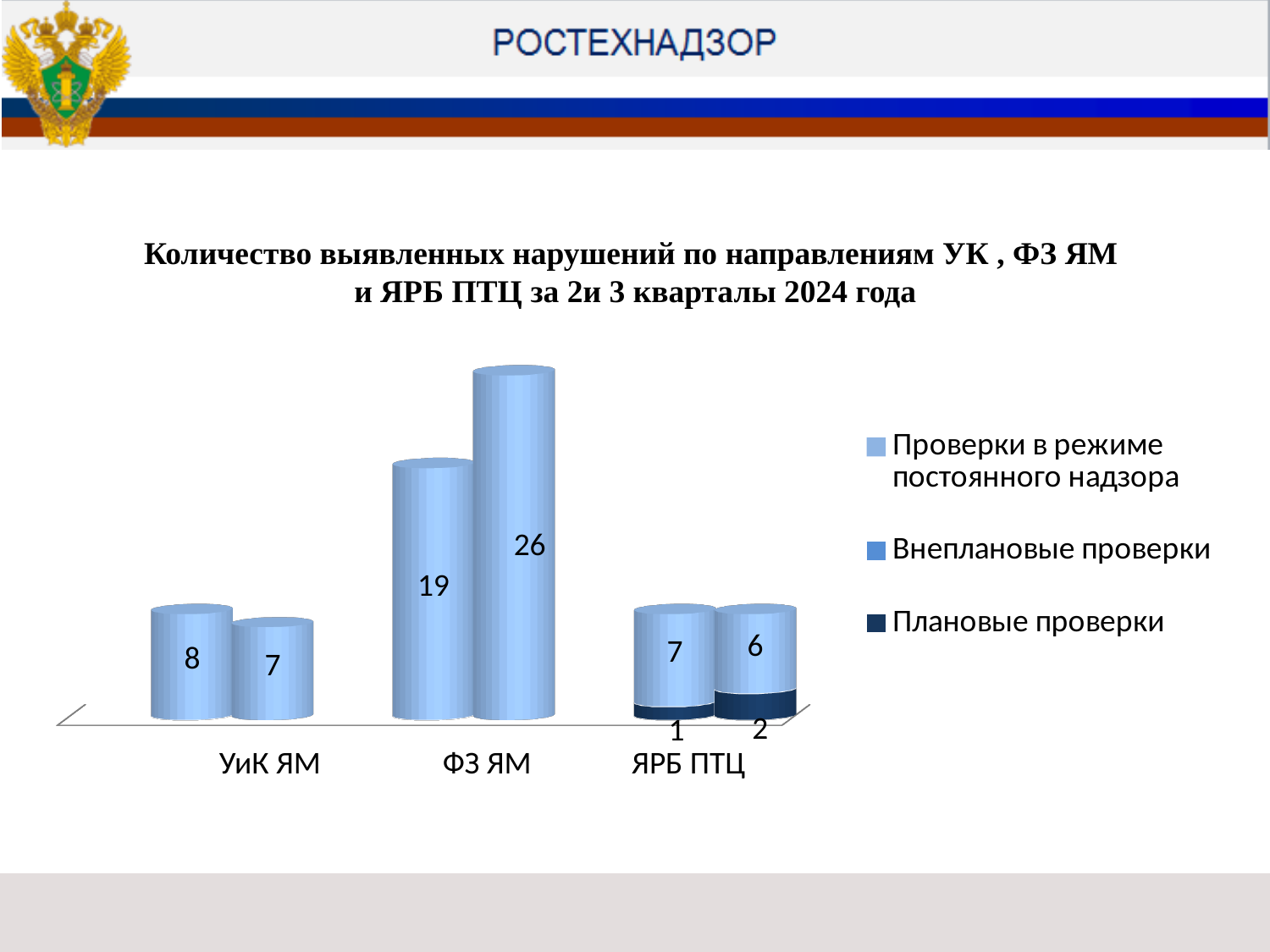
How many categories are shown along the x axis of the chart? 3 Which legend entry is shown in dark blue? Плановые проверки What kind of chart is shown on the slide? bar chart What is the total of the right-hand stacked bar for ЯРБ ПТЦ (6 plus 2)? 8 Which is larger: the value 26 for ФЗ ЯМ or the value 8 for УиК ЯМ? 26 for ФЗ ЯМ What are the two light-blue data labels shown for the УиК ЯМ category? 8 and 7 What are the two data labels shown for the dark-blue Плановые проверки segments in the ЯРБ ПТЦ category? 1 and 2 What is the largest data label shown for the ФЗ ЯМ category? 26 Which category is the only one with visible dark-blue Плановые проверки segments? ЯРБ ПТЦ How many series does the chart legend list? 3 What is the difference between the two light-blue values shown for ФЗ ЯМ (26 and 19)? 7 Which category has the tallest bar in the chart? ФЗ ЯМ